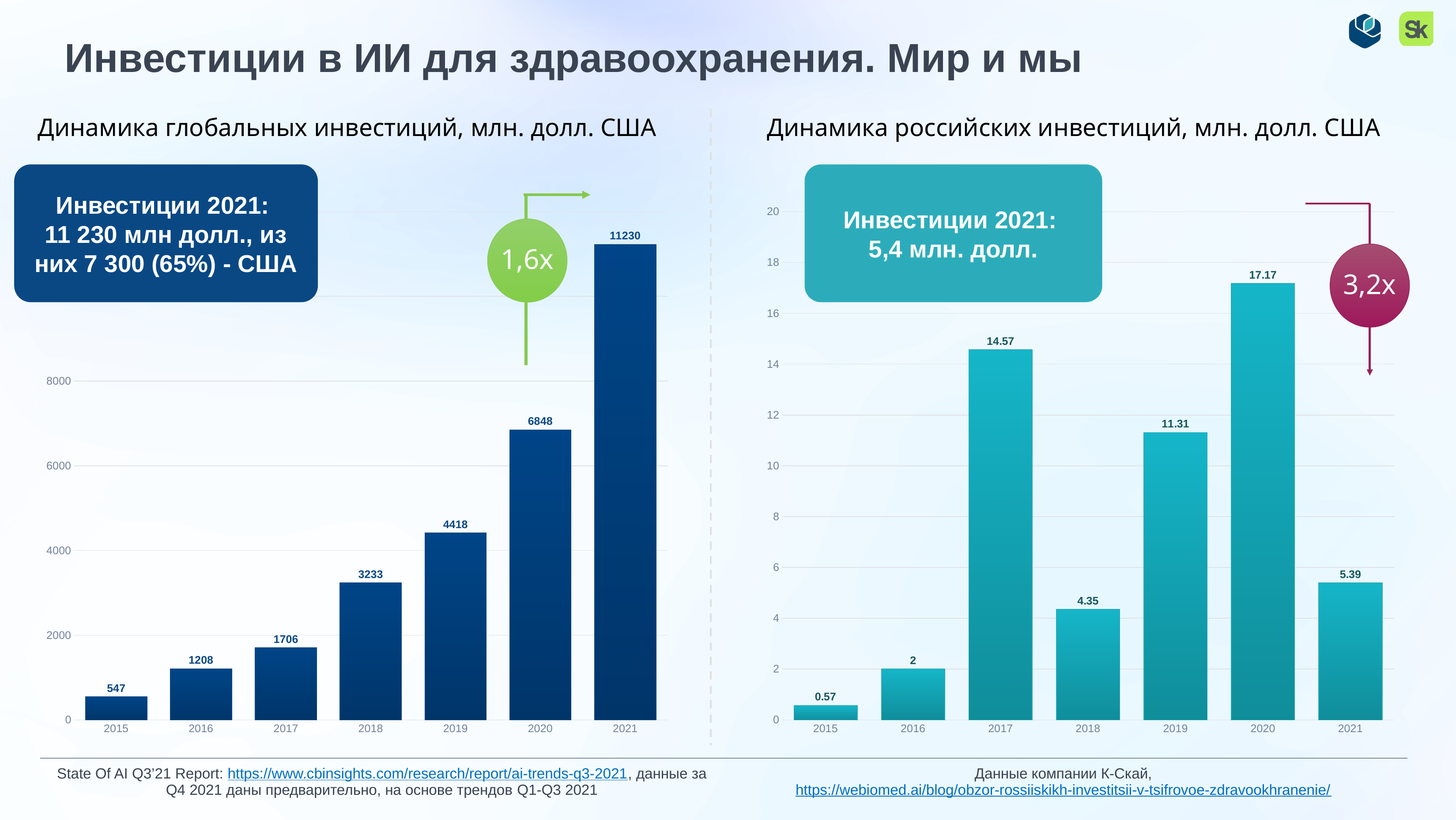
In the right chart (Динамика российских инвестиций), which year has the lowest value? 2015 In the right chart (Динамика российских инвестиций), what is the value for 2020? 17.17 In the right chart (Динамика российских инвестиций), what is the value for 2018? 4.35 In the left chart (Динамика глобальных инвестиций), what is the value for 2019? 4418 In the left chart (Динамика глобальных инвестиций), do the values rise or fall from 2015 to 2021? rise In the left chart (Динамика глобальных инвестиций), what is the value for 2015? 547 In the left chart (Динамика глобальных инвестиций), how many years are shown on the x axis? 7 In the right chart (Динамика российских инвестиций), which is larger, the value for 2017 or the value for 2019? 2017 What kind of chart is the right chart (Динамика российских инвестиций)? bar chart In the right chart (Динамика российских инвестиций), what is the difference between the values for 2020 and 2021? 11.78 In the left chart (Динамика глобальных инвестиций), which year has the highest value? 2021 In the left chart (Динамика глобальных инвестиций), what is the difference between the values for 2021 and 2020? 4382